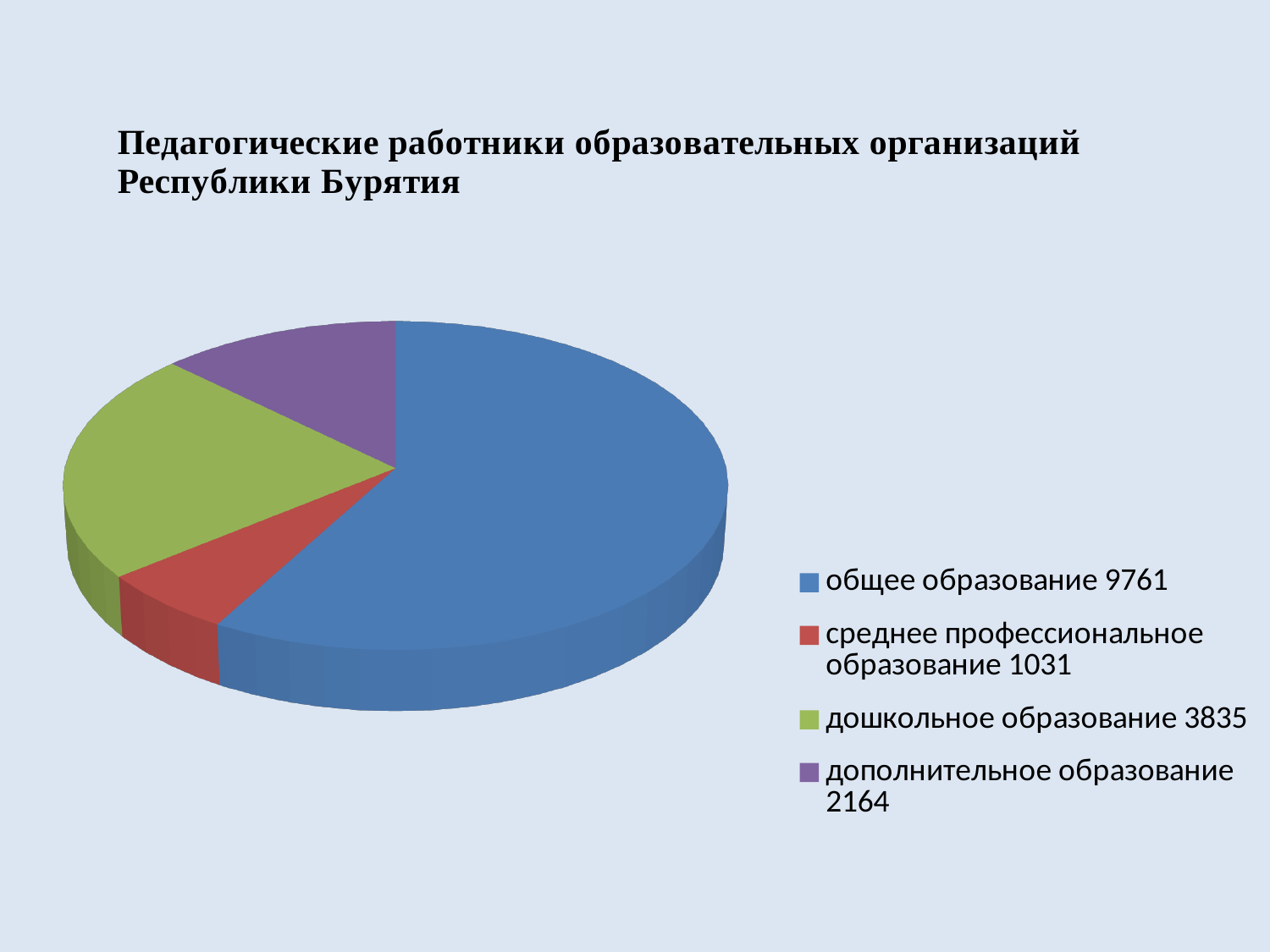
What is the value for дошкольное образование? 3835 What kind of chart is shown on the slide? pie chart Which category has the smallest slice of the pie? среднее профессиональное образование Which is larger, дополнительное образование or среднее профессиональное образование? дополнительное образование What is the value for среднее профессиональное образование? 1031 How many categories does the pie chart show? 4 What is the difference between the values for общее образование and дошкольное образование? 5926 What is the difference between the values for дошкольное образование and дополнительное образование? 1671 What colour is the slice for дошкольное образование? green Which category has the largest slice of the pie? общее образование What is the value for дополнительное образование? 2164 What is the value for общее образование? 9761